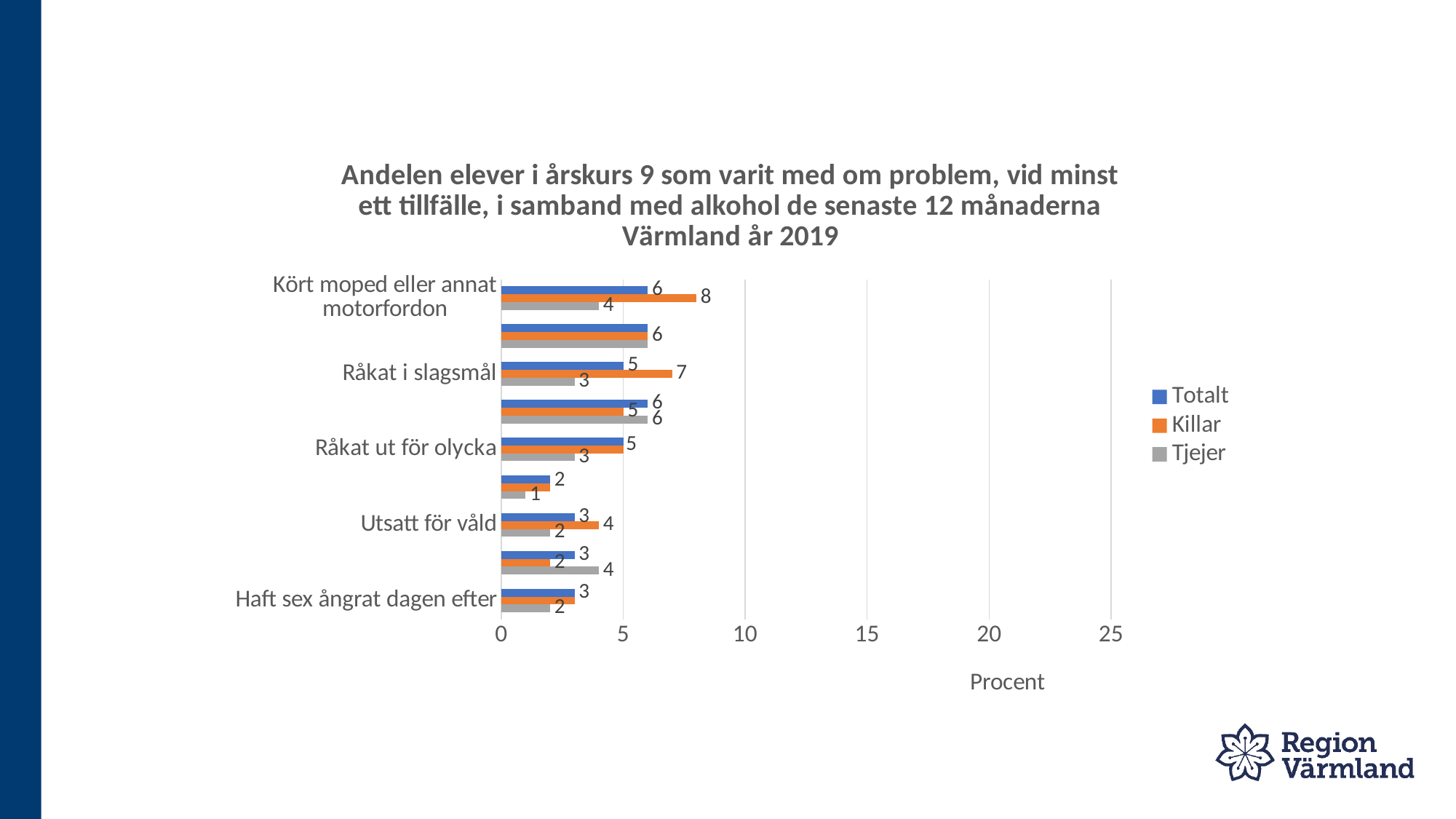
What is the value for Killar in the category 'Råkat i slagsmål'? 7 In the category 'Råkat i slagsmål', which is larger, the value for Killar or the value for Tjejer? Killar What is the value for Totalt in the category 'Råkat i slagsmål'? 5 What is the difference between the Killar and Tjejer values for 'Kört moped eller annat motorfordon'? 4 What is the title of the horizontal axis? Procent What is the value for Totalt in the category 'Haft sex ångrat dagen efter'? 3 What is the value for Tjejer in the category 'Kört moped eller annat motorfordon'? 4 How many series does the legend list? 3 What kind of chart is shown on the slide? bar chart What is the value for Killar in the category 'Utsatt för våld'? 4 Is the value for Killar in 'Kört moped eller annat motorfordon' greater or less than 10? less What is the value for Killar in the category 'Kört moped eller annat motorfordon'? 8